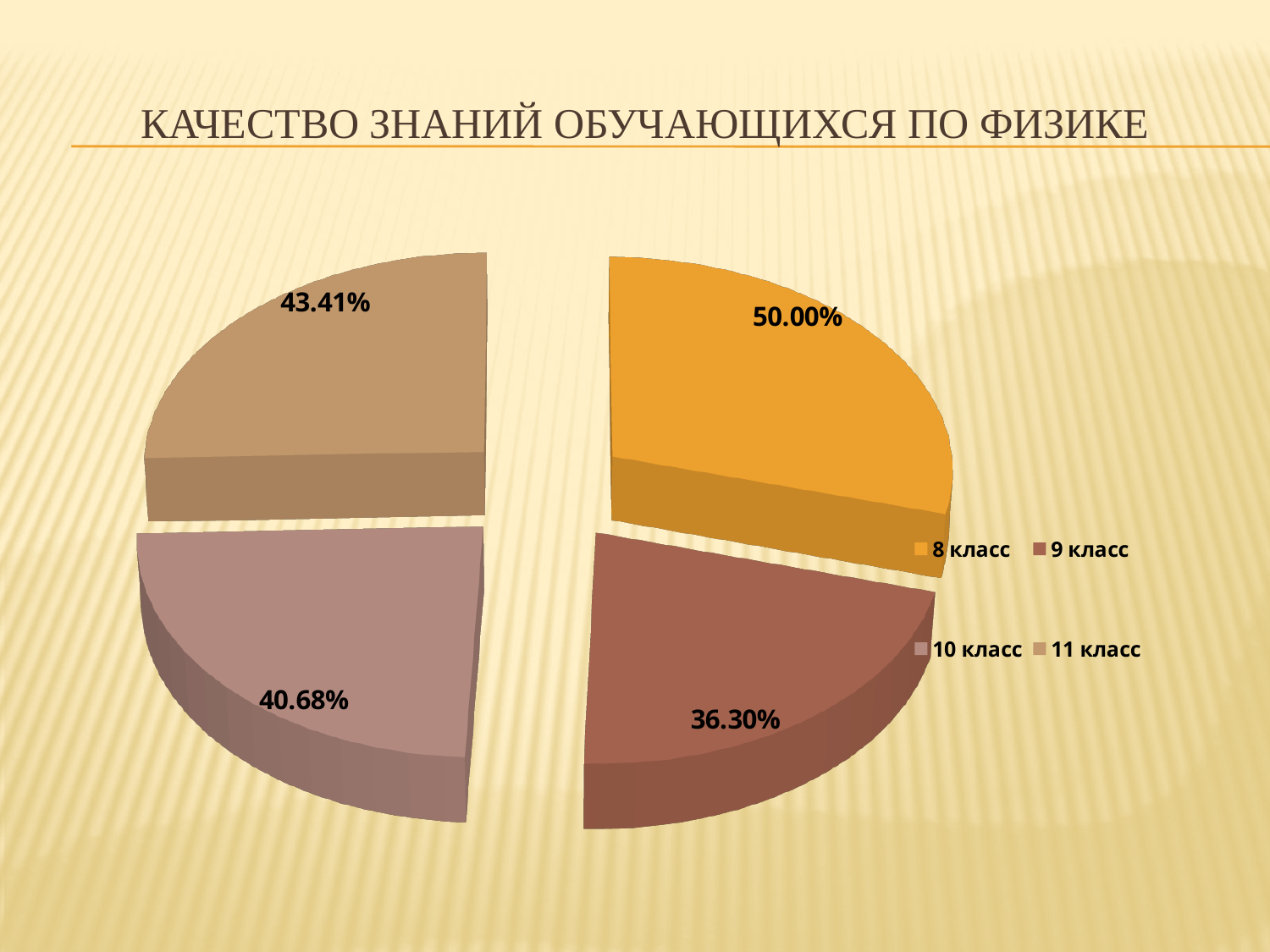
What is the value shown for 9 класс? 36.30% Which is larger, the value for 10 класс or the value for 11 класс? 11 класс What kind of chart is shown on the slide? pie chart Which class has the lowest value in the chart? 9 класс Which class has the highest value in the chart? 8 класс What is the difference between the values for 8 класс and 9 класс? 13.70% What is the value shown for 10 класс? 40.68% What is the value shown for 8 класс? 50.00% What is the title of the slide? Качество знаний обучающихся по физике How many entries does the legend list? 4 What is the value shown for 11 класс? 43.41% How many slices does the pie chart have? 4